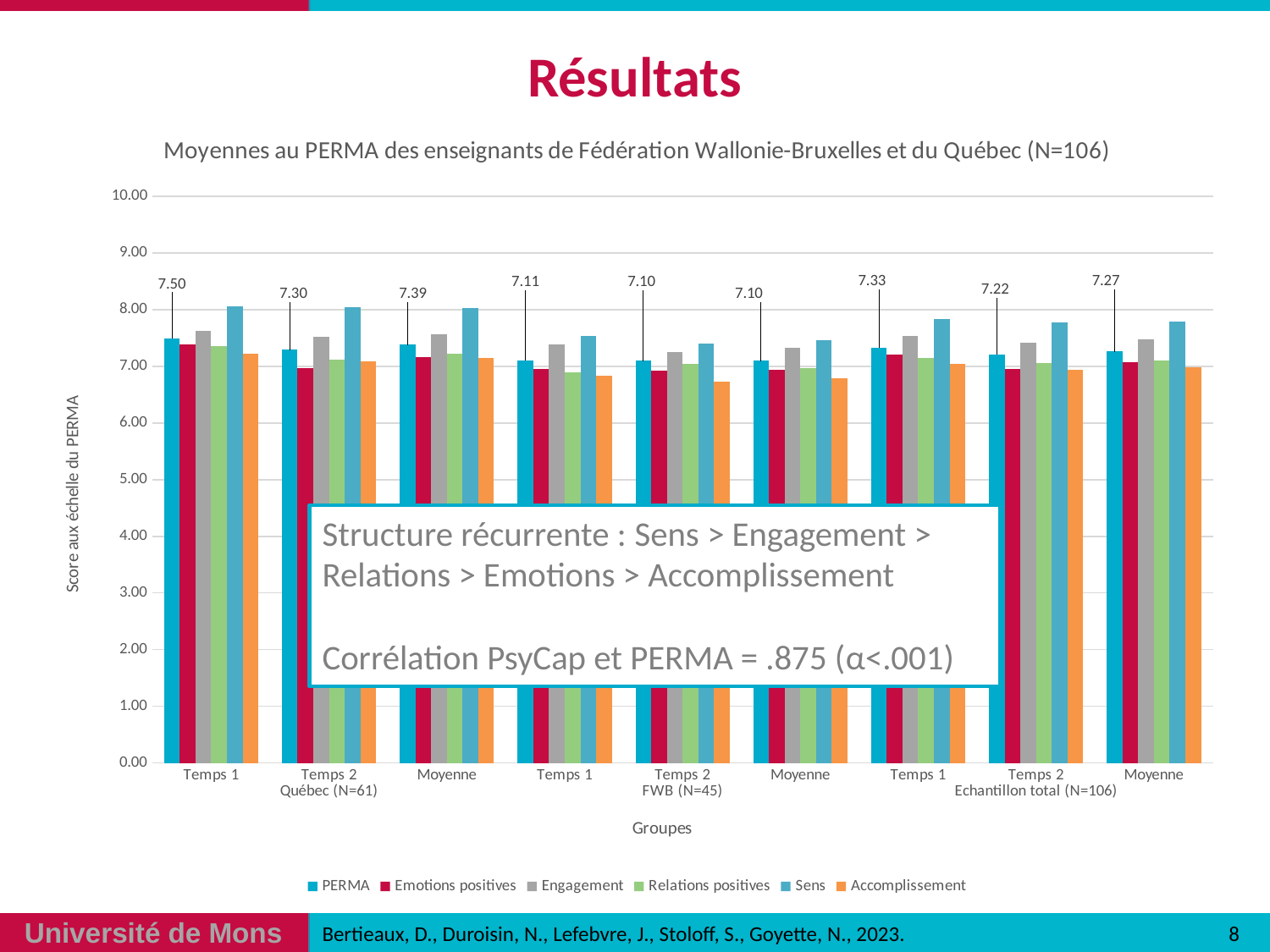
Is the Sens value for Temps 1 in the Echantillon total (N=106) group greater or less than 8.00? less Which is larger: the PERMA value for Temps 1 in Québec (N=61) or for Temps 1 in FWB (N=45)? Temps 1 in Québec (N=61) Which category has the highest labelled PERMA value? Temps 1 (Québec, N=61) What is the PERMA value for Moyenne in the Echantillon total (N=106) group? 7.27 What is the PERMA value for Temps 2 in the FWB (N=45) group? 7.10 How many category groups are shown along the x axis? 9 What is the difference between the PERMA values for Temps 1 and Temps 2 in the Echantillon total (N=106) group? 0.11 What is the difference between the PERMA values for Temps 1 and Temps 2 in the Québec (N=61) group? 0.20 How many series does the legend list? 6 Is the Accomplissement value for Temps 2 in the FWB (N=45) group greater or less than 7.00? less What kind of chart is shown on the slide? Bar chart What is the PERMA value for Temps 1 in the Québec (N=61) group? 7.50